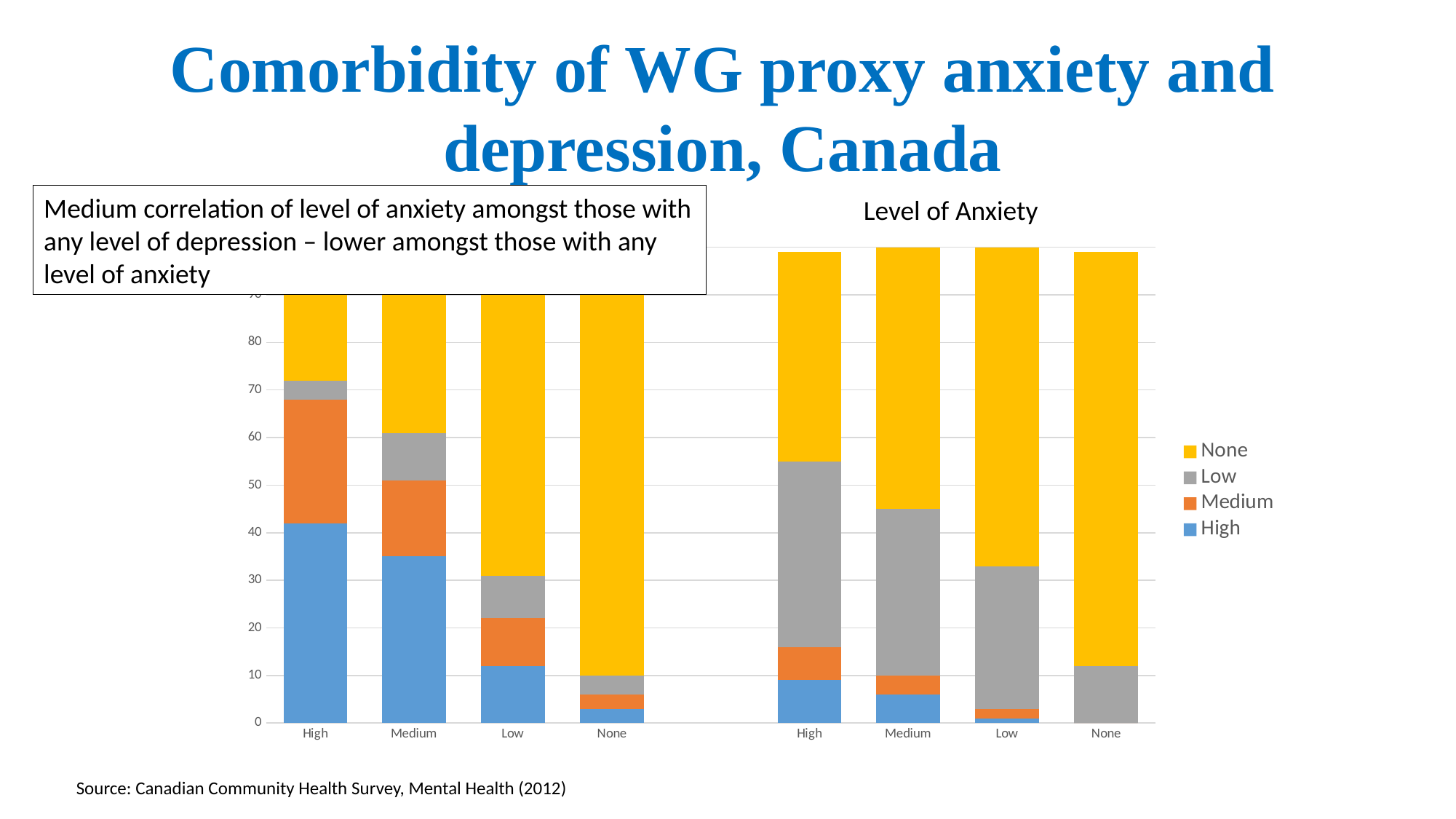
What kind of chart is shown on the slide? Stacked bar chart How many bars are plotted in total across both groups? 8 Which bar in the left-hand group has the largest blue (High) segment? High In the right-hand 'Level of Anxiety' group, is the blue (High) segment of the 'High' bar greater or less than 20? less How many categories are on the x axis of the right-hand 'Level of Anxiety' group? 4 Is the blue (High) segment larger for the 'High' bar in the left-hand group or for the 'High' bar in the right-hand 'Level of Anxiety' group? Left-hand group What are the four entries in the legend? None, Low, Medium, High How many series does the legend list? 4 In the left-hand group, is the blue (High) segment of the 'High' bar greater or less than 30? greater Which bar in the right-hand 'Level of Anxiety' group has the smallest grey (Low) segment? None What is the title shown above the right-hand group of bars? Level of Anxiety In the left-hand group, is the blue (High) segment of the 'None' bar greater or less than 10? less